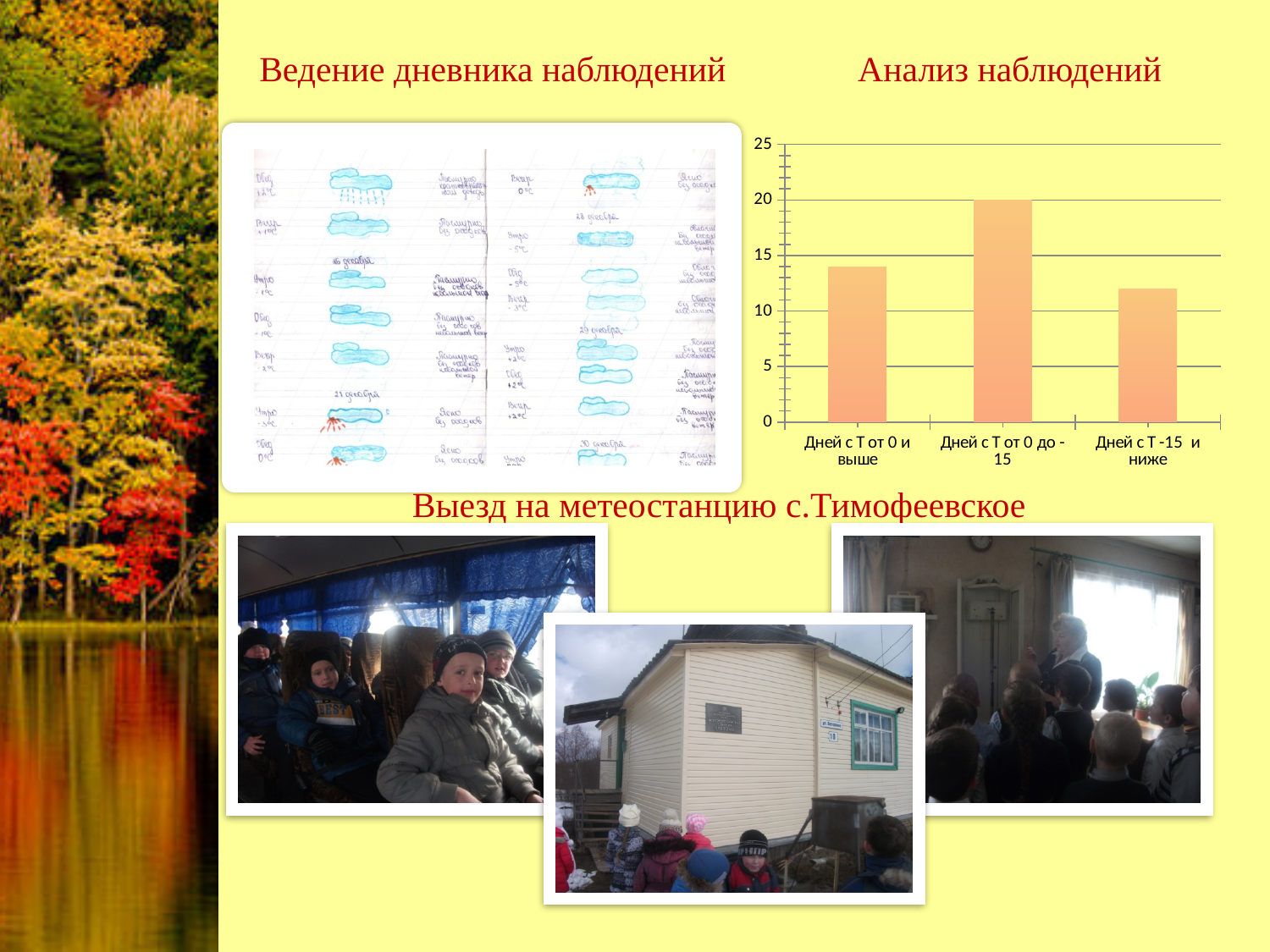
Is the value for "Дней с Т от 0 и выше" greater or less than 15? less What is the highest value shown on the vertical axis of the chart? 25 How many categories are shown on the bar chart? 3 What is the value for "Дней с Т от 0 до -15" on the chart? 20 Which is larger on the chart: the value for "Дней с Т от 0 и выше" or for "Дней с Т -15 и ниже"? Дней с Т от 0 и выше Is the value for "Дней с Т -15 и ниже" greater or less than 15? less Which category has the highest bar on the chart? Дней с Т от 0 до -15 Is the value for "Дней с Т от 0 и выше" greater or less than 10? greater Which category has the lowest bar on the chart? Дней с Т -15 и ниже What heading appears above the bar chart? Анализ наблюдений What kind of chart is shown under the heading "Анализ наблюдений"? bar chart